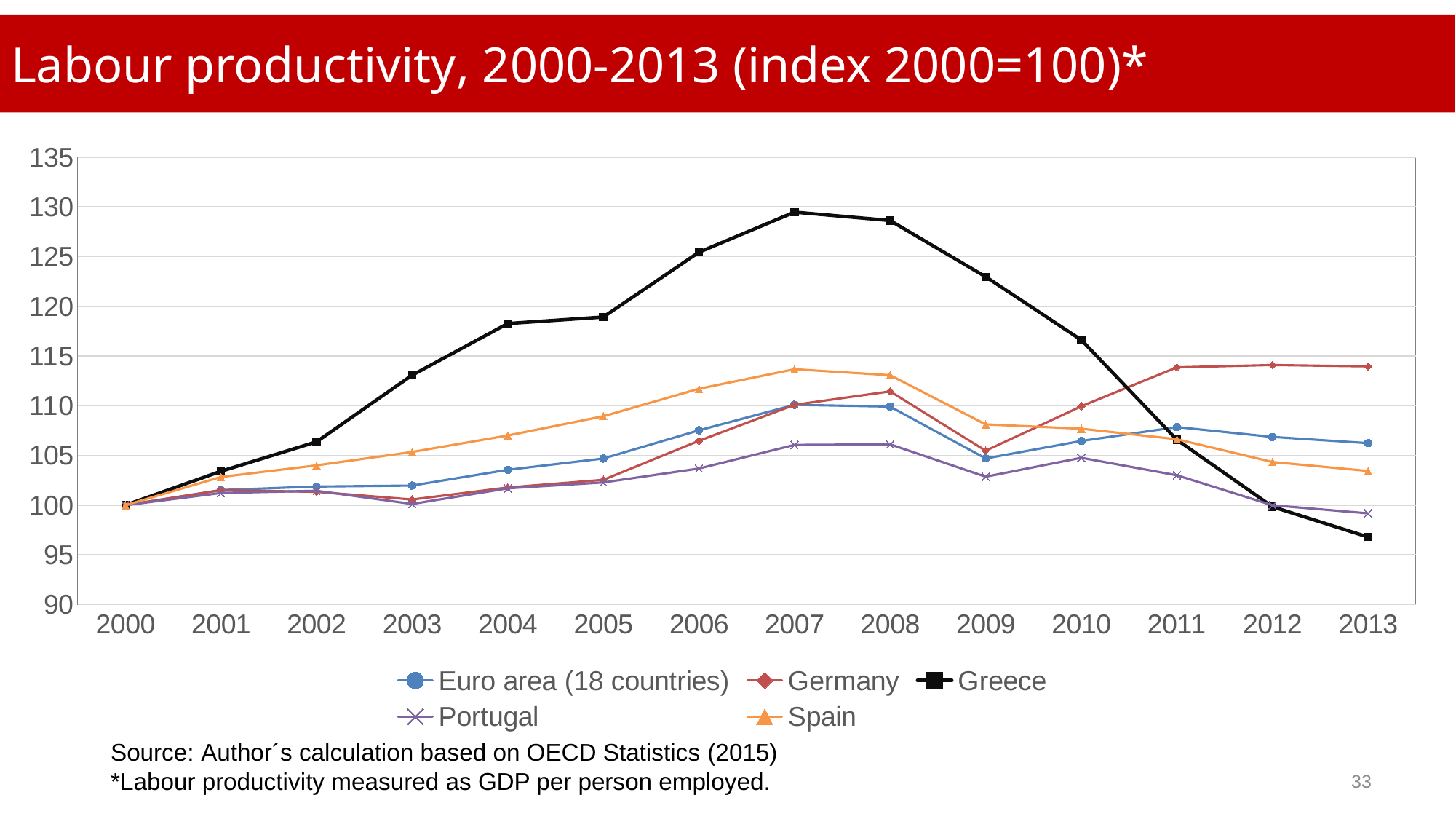
Is the value for Greece in 2013 greater or less than 100? less Does the value for Greece rise or fall from 2007 to 2013? fall Which series has the lowest value in 2013? Greece What is the value for Greece in 2000? 100 How many series does the legend list? 5 What kind of chart is shown on the slide? line chart How many years are plotted along the x axis? 14 Is the value for Greece in 2007 greater or less than 125? greater In 2013, which is larger: the value for Germany or the value for Spain? Germany Which series has the highest value in 2007? Greece What is the title of the chart? Labour productivity, 2000-2013 (index 2000=100)* Is the value for Germany in 2011 greater or less than 110? greater